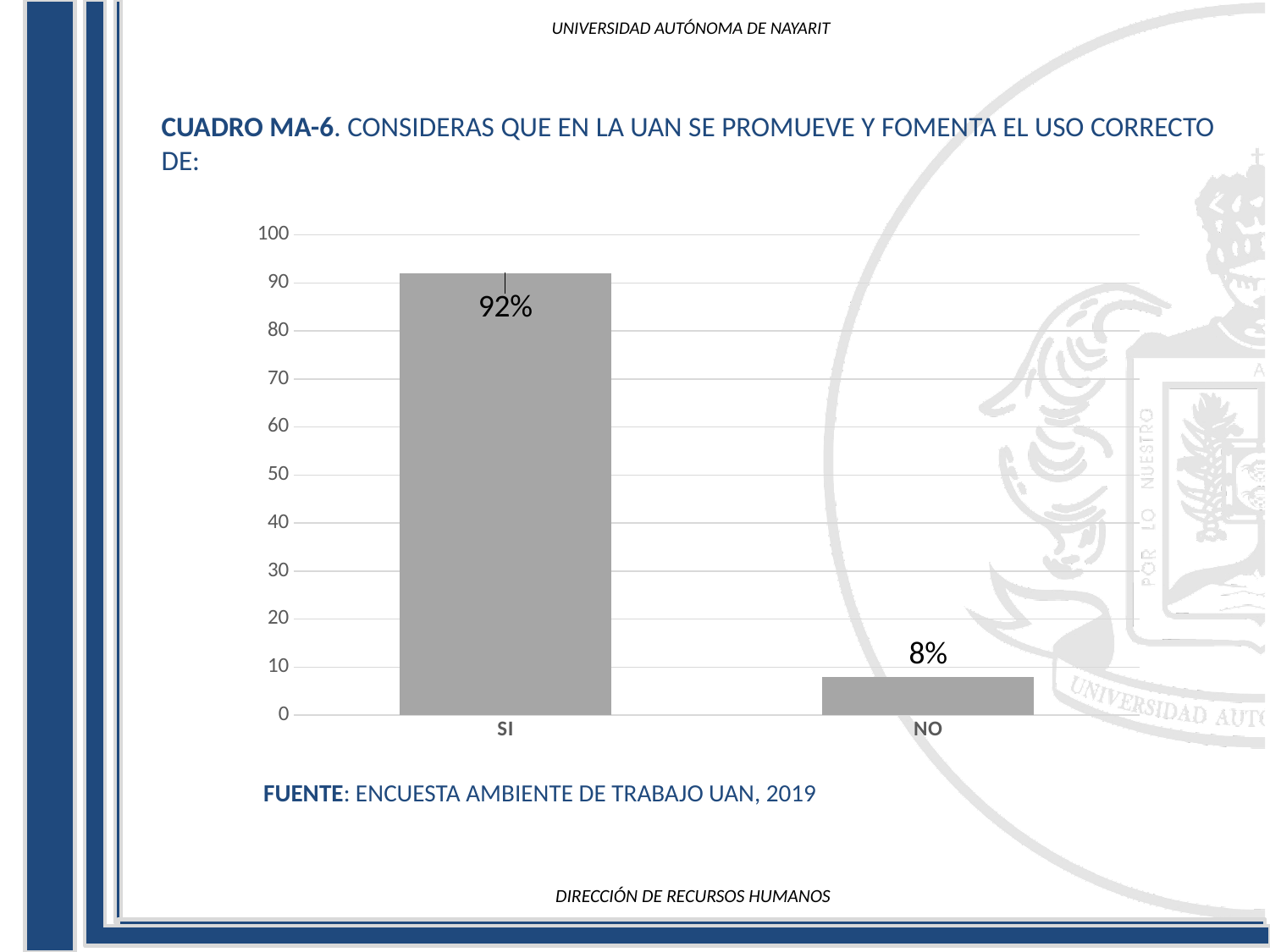
What kind of chart is shown on the slide? bar chart Is the value for SI greater or less than 50? greater Which category has the lowest value? NO How many categories are shown on the x axis? 2 What is the difference between the values for SI and NO? 84% Which category has the highest value? SI Is the value for NO greater or less than 10? less What is the value for NO? 8% What is the source cited below the chart? ENCUESTA AMBIENTE DE TRABAJO UAN, 2019 What is the value for SI? 92% Which is larger, the value for SI or the value for NO? SI What is the highest value shown on the y axis? 100